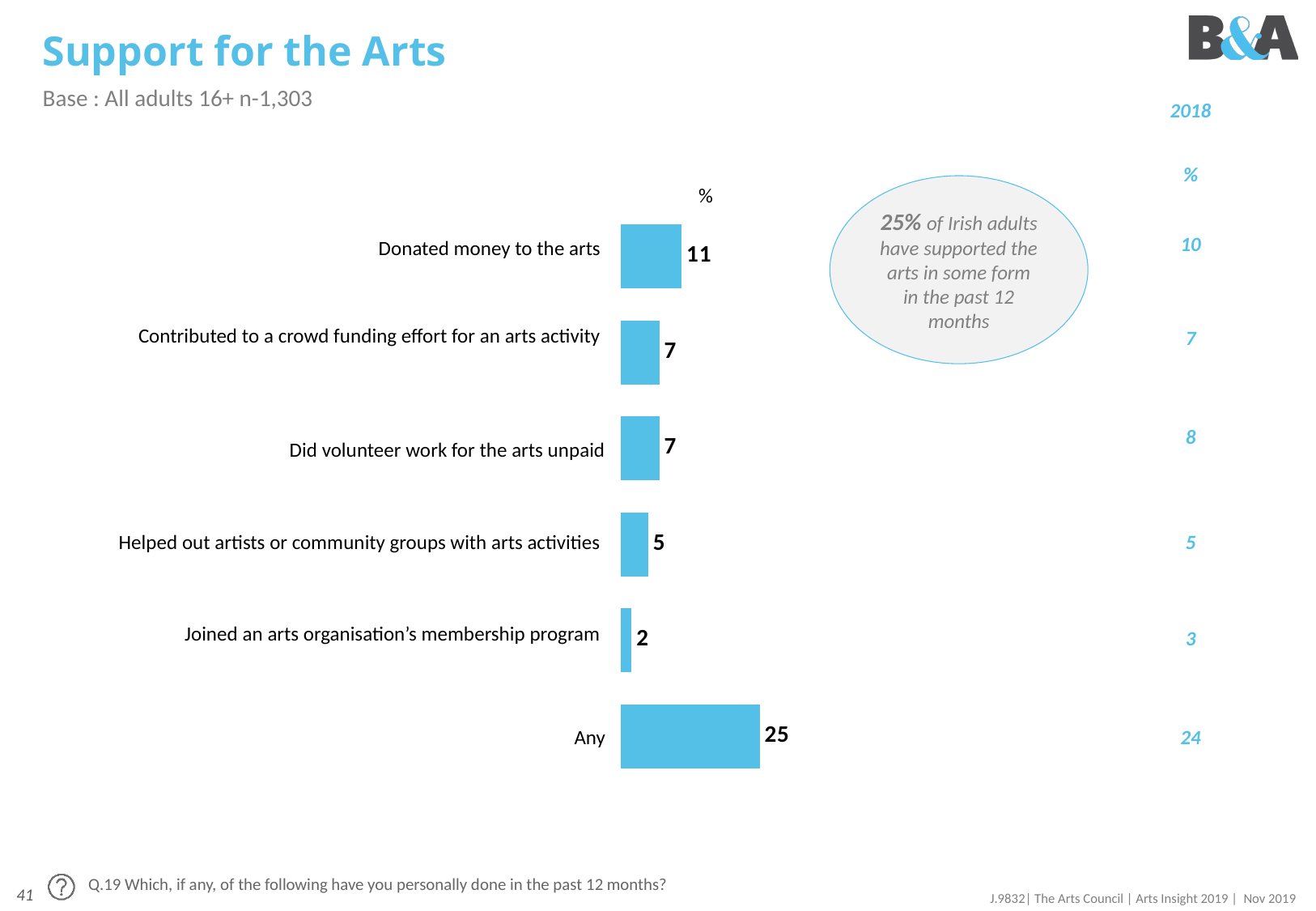
What is the title of the slide containing the chart? Support for the Arts How many categories are shown in the chart? 6 What is the difference between the values for "Any" and "Donated money to the arts"? 14 What is the difference between the values for "Donated money to the arts" and "Did volunteer work for the arts unpaid"? 4 What is the value for "Joined an arts organisation's membership program"? 2 What kind of chart is shown on the slide? Bar chart What is the value for "Helped out artists or community groups with arts activities"? 5 Which category has the lowest value? Joined an arts organisation's membership program What is the value for "Any"? 25 Which is larger: the value for "Donated money to the arts" or the value for "Helped out artists or community groups with arts activities"? Donated money to the arts What is the value for "Donated money to the arts"? 11 Which category has the highest value? Any